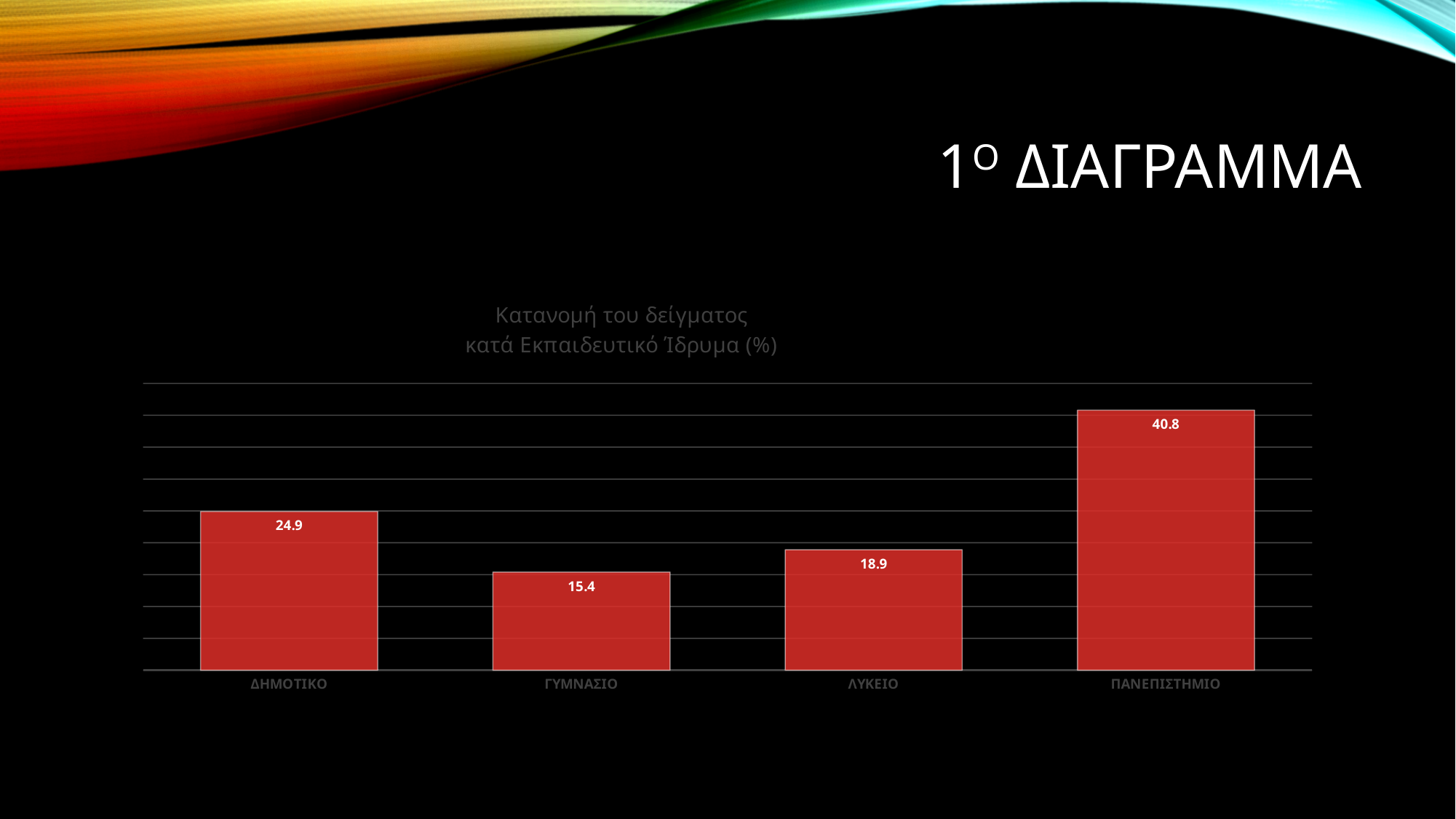
What is the difference between the values for ΠΑΝΕΠΙΣΤΗΜΙΟ and ΔΗΜΟΤΙΚΟ? 15.9 What is the value for ΛΥΚΕΙΟ? 18.9 What is the value for ΔΗΜΟΤΙΚΟ? 24.9 Which category has the lowest value? ΓΥΜΝΑΣΙΟ What is the value for ΓΥΜΝΑΣΙΟ? 15.4 What kind of chart is shown on the slide? Bar chart What is the title of the chart? Κατανομή του δείγματος κατά Εκπαιδευτικό Ίδρυμα (%) Which category has the highest value? ΠΑΝΕΠΙΣΤΗΜΙΟ What is the difference between the values for ΛΥΚΕΙΟ and ΓΥΜΝΑΣΙΟ? 3.5 Which is larger, the value for ΔΗΜΟΤΙΚΟ or the value for ΛΥΚΕΙΟ? ΔΗΜΟΤΙΚΟ What is the value for ΠΑΝΕΠΙΣΤΗΜΙΟ? 40.8 How many categories are shown in the chart? 4